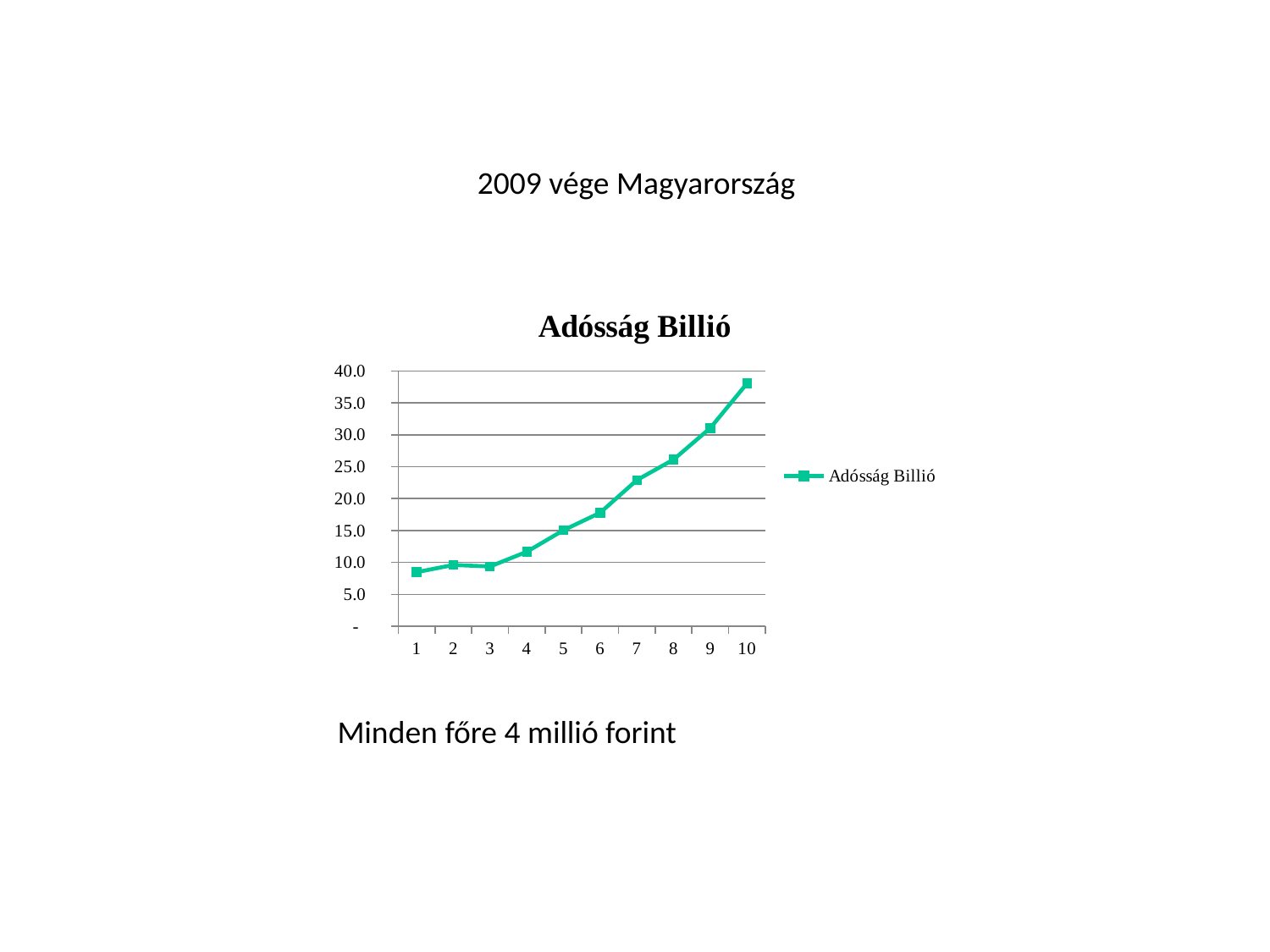
Is the value for category 1 greater or less than 10.0? less Is the value for category 10 greater or less than 35.0? greater Which x-axis category has the highest value? 10 Do the values generally rise or fall from category 1 to category 10? rise Which x-axis category has the lowest value? 1 How many series does the legend list? 1 Is the value for category 7 greater or less than 20.0? greater What is the title of the chart? Adósság Billió How many points are plotted along the x axis? 10 What kind of chart is shown on the slide? line chart Which is larger, the value for category 2 or the value for category 6? 6